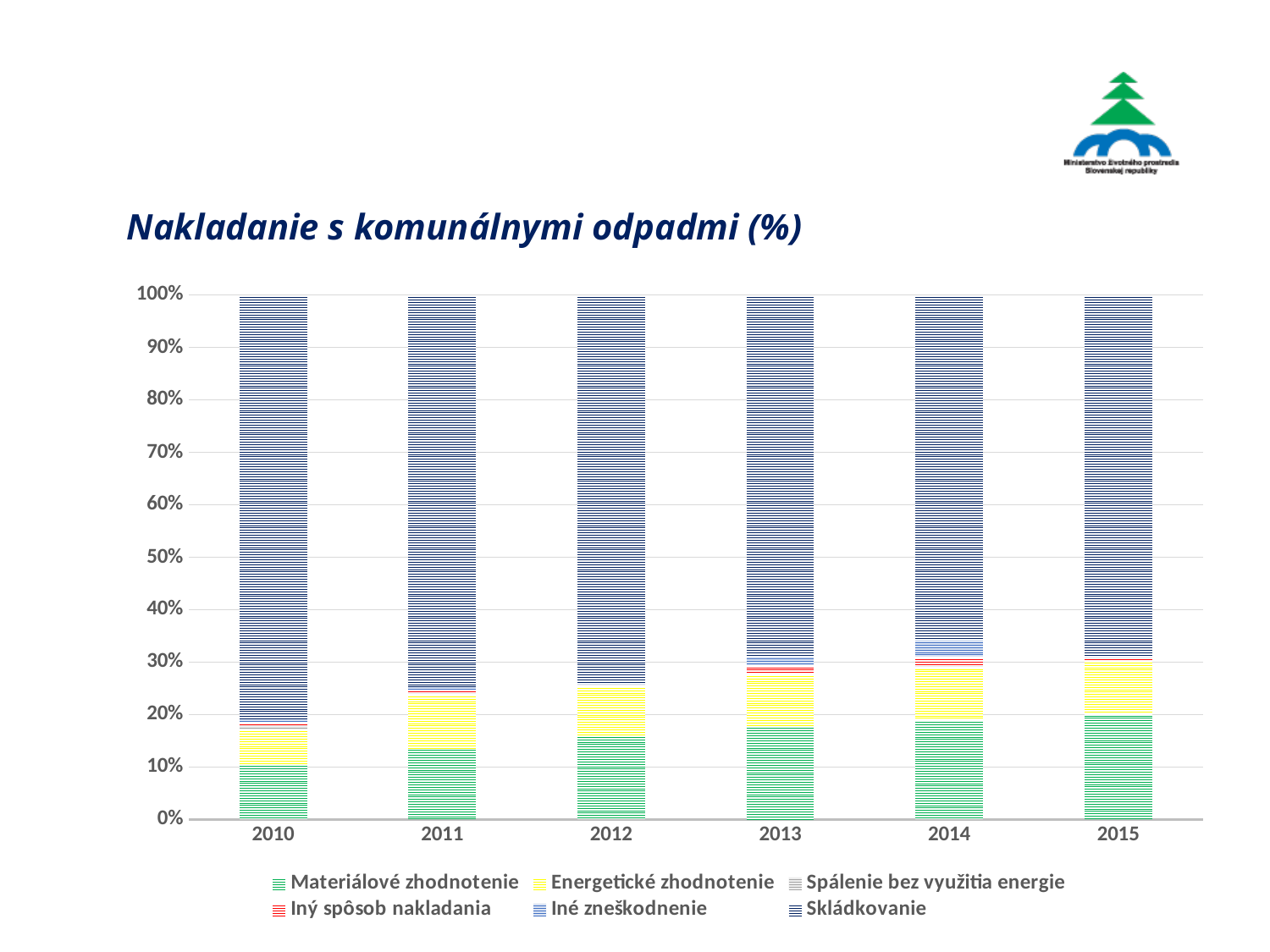
What is the title of the chart? Nakladanie s komunálnymi odpadmi (%) Is the Materiálové zhodnotenie value for 2010 greater or less than 20%? less How many series does the legend list? 6 Does the Skládkovanie share rise or fall from 2010 to 2015? fall What kind of chart is shown on the slide? stacked bar chart How many years are shown on the x axis of the chart? 6 Which year has the larger Materiálové zhodnotenie segment, 2010 or 2013? 2013 In which year is the Skládkovanie segment largest? 2010 Is the Skládkovanie share for 2010 greater or less than 70%? greater Does the Materiálové zhodnotenie share rise or fall from 2010 to 2015? rise In which year is the Materiálové zhodnotenie segment smallest? 2010 Is the Materiálové zhodnotenie value for 2015 greater or less than 10%? greater